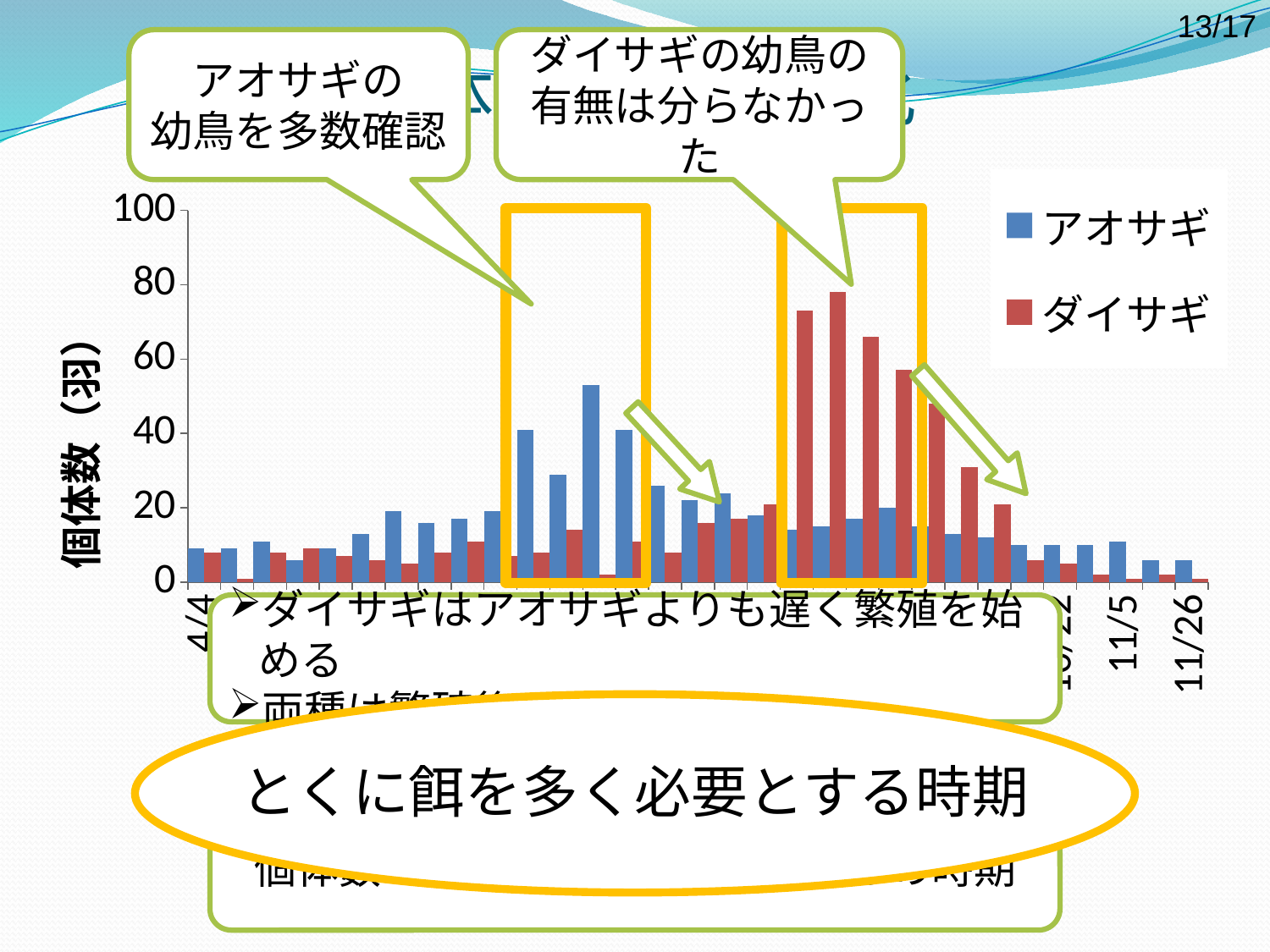
What is the title of the vertical axis of the chart? 個体数（羽） Is the アオサギ value for 11/26 greater or less than 20? less What kind of chart is shown on the slide? bar chart Is the highest ダイサギ value on the chart greater or less than 60? greater Is the ダイサギ value for 11/5 greater or less than 20? less What are the two series named in the chart's legend? アオサギ and ダイサギ Which series has the tallest bar anywhere on the chart, アオサギ or ダイサギ? ダイサギ What is the highest tick value shown on the vertical axis of the chart? 100 How many series does the chart's legend list? 2